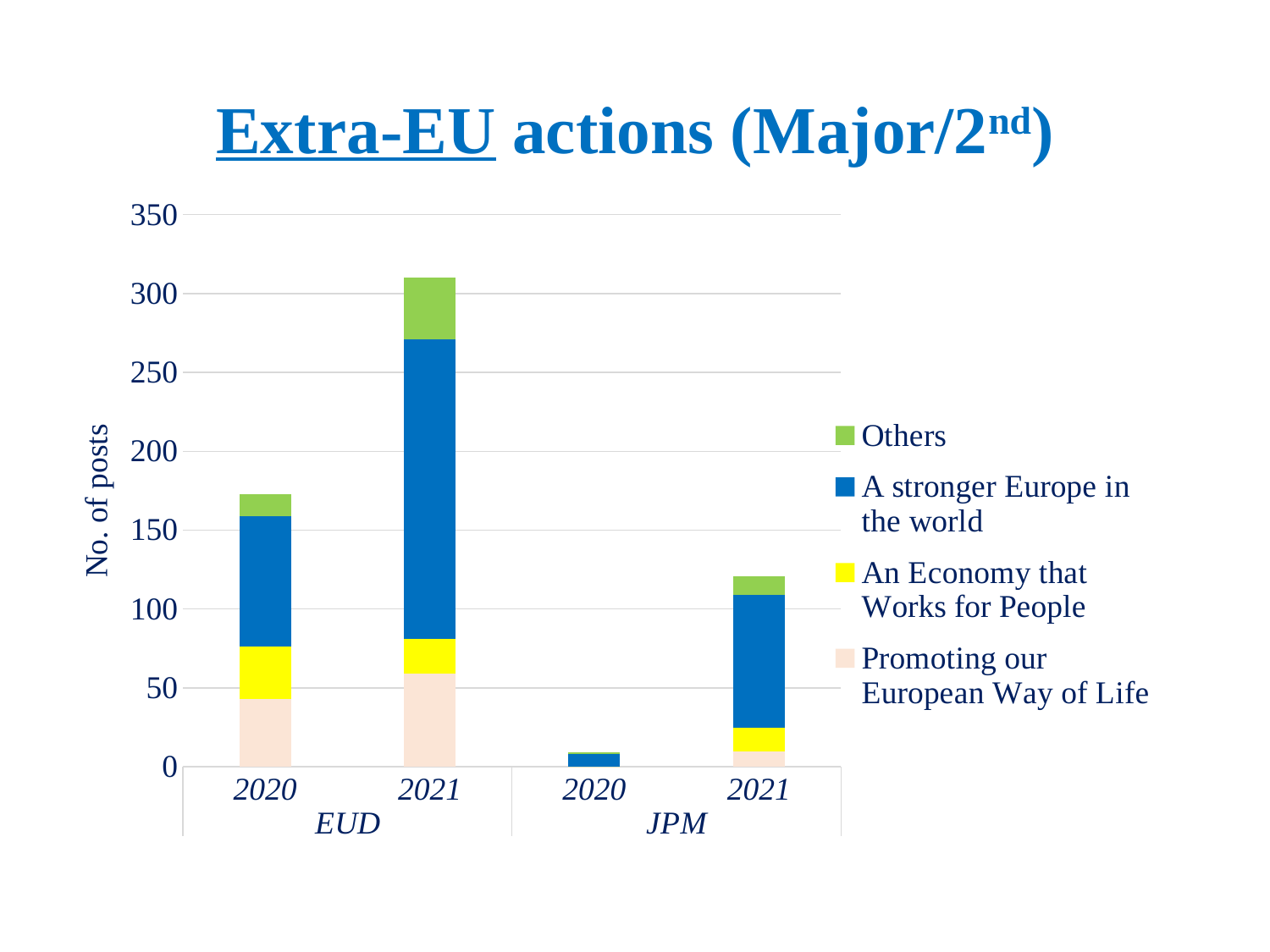
How many series does the legend list? 4 Which bar has the highest total number of posts? EUD 2021 Which has a larger total number of posts, EUD 2020 or JPM 2021? EUD 2020 Which bar has the lowest total number of posts? JPM 2020 Is the total for JPM 2021 greater or less than 100? greater Is the total for EUD 2021 greater or less than 300? greater How many bars are plotted in the chart? 4 Is the total for EUD 2020 greater or less than 200? less What kind of chart is shown on the slide? Stacked bar chart What is the label on the vertical axis? No. of posts For the EUD group, does the total number of posts rise or fall from 2020 to 2021? rise